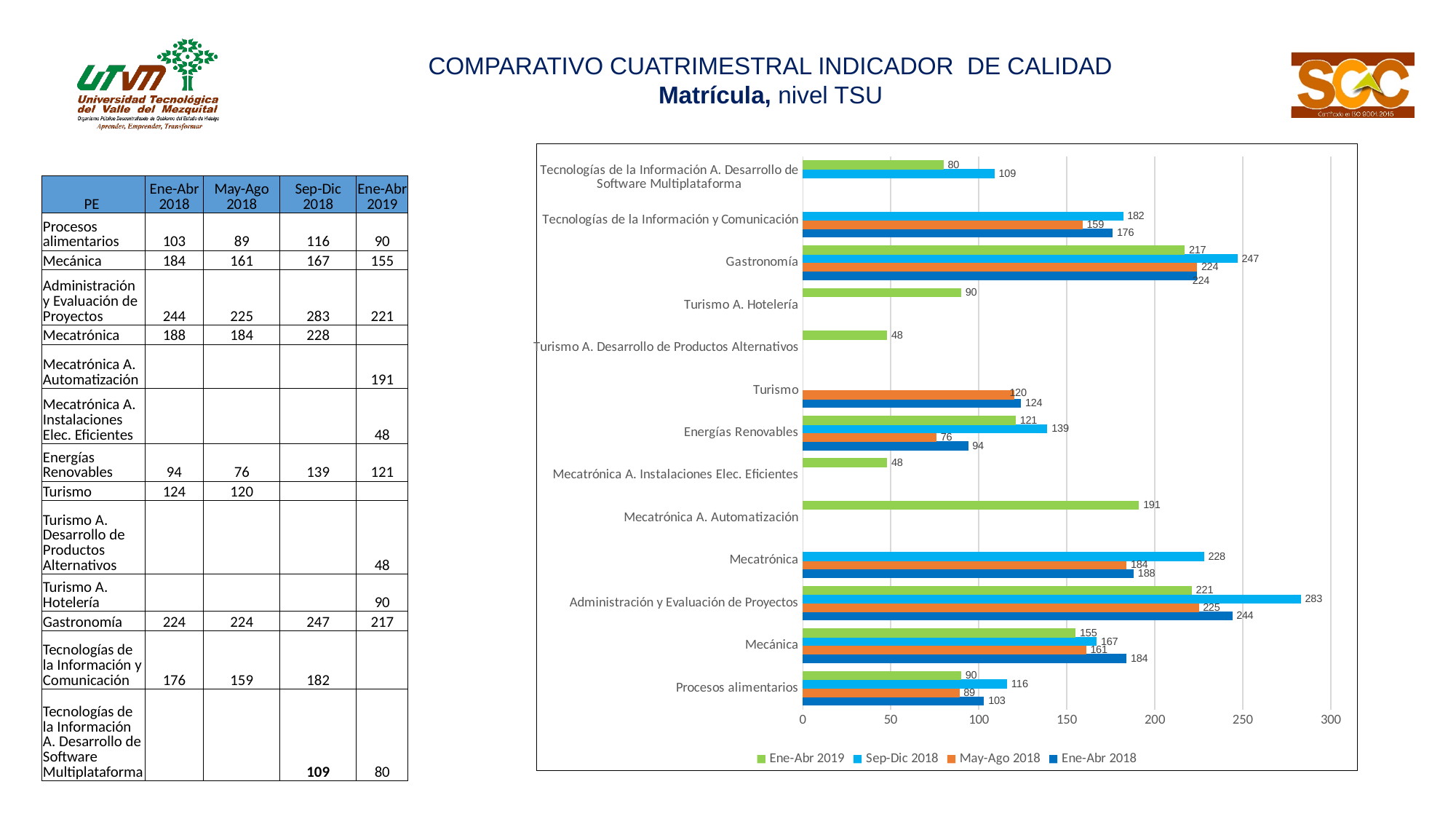
What is the Sep-Dic 2018 value for Administración y Evaluación de Proyectos? 283 What is the Ene-Abr 2019 value for Gastronomía? 217 How many categories (programs) are shown on the chart's vertical axis? 13 Which category has the highest Sep-Dic 2018 value? Administración y Evaluación de Proyectos How many series does the legend list? 4 Which is larger for Sep-Dic 2018: Gastronomía or Mecatrónica? Gastronomía Which category has the lowest Ene-Abr 2018 value? Energías Renovables What kind of chart is shown on the slide? bar chart Is the Ene-Abr 2019 value for Mecatrónica A. Automatización greater or less than 150? greater What is the May-Ago 2018 value for Turismo? 120 What is the Sep-Dic 2018 value for Energías Renovables? 139 What is the difference between the Ene-Abr 2018 and Ene-Abr 2019 values for Mecánica? 29